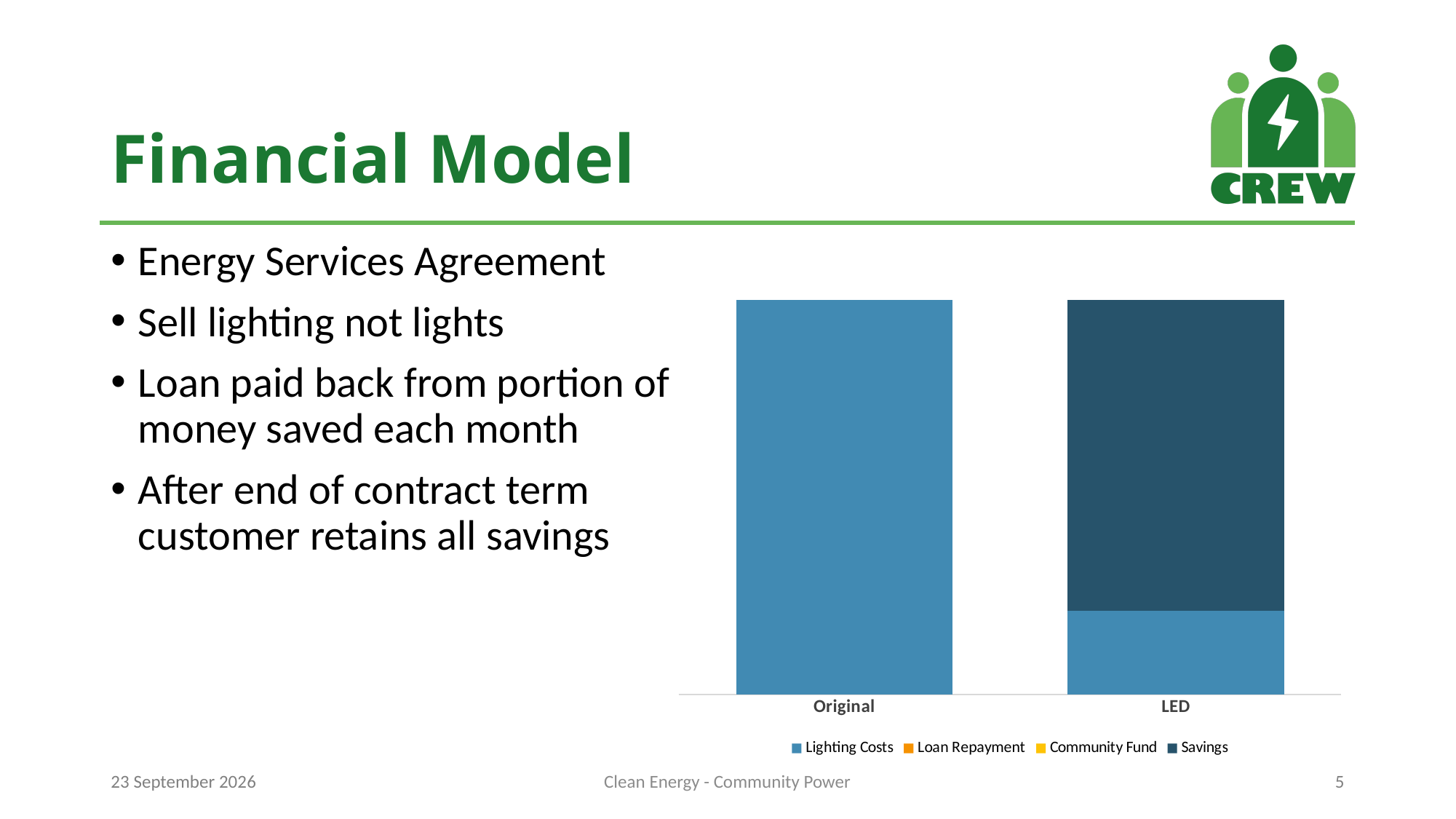
Which category shows a Savings segment in its bar? LED How many series does the chart's legend list? 4 Which category has the larger Lighting Costs segment, Original or LED? Original In the LED bar, which segment is larger, Lighting Costs or Savings? Savings Which series makes up the entire bar for the Original category? Lighting Costs What kind of chart is shown on the slide? Stacked bar chart Which category has the smaller Lighting Costs segment? LED What are the two categories on the x axis of the chart? Original and LED Which series is listed last in the chart's legend? Savings How many categories are shown on the x axis of the chart? 2